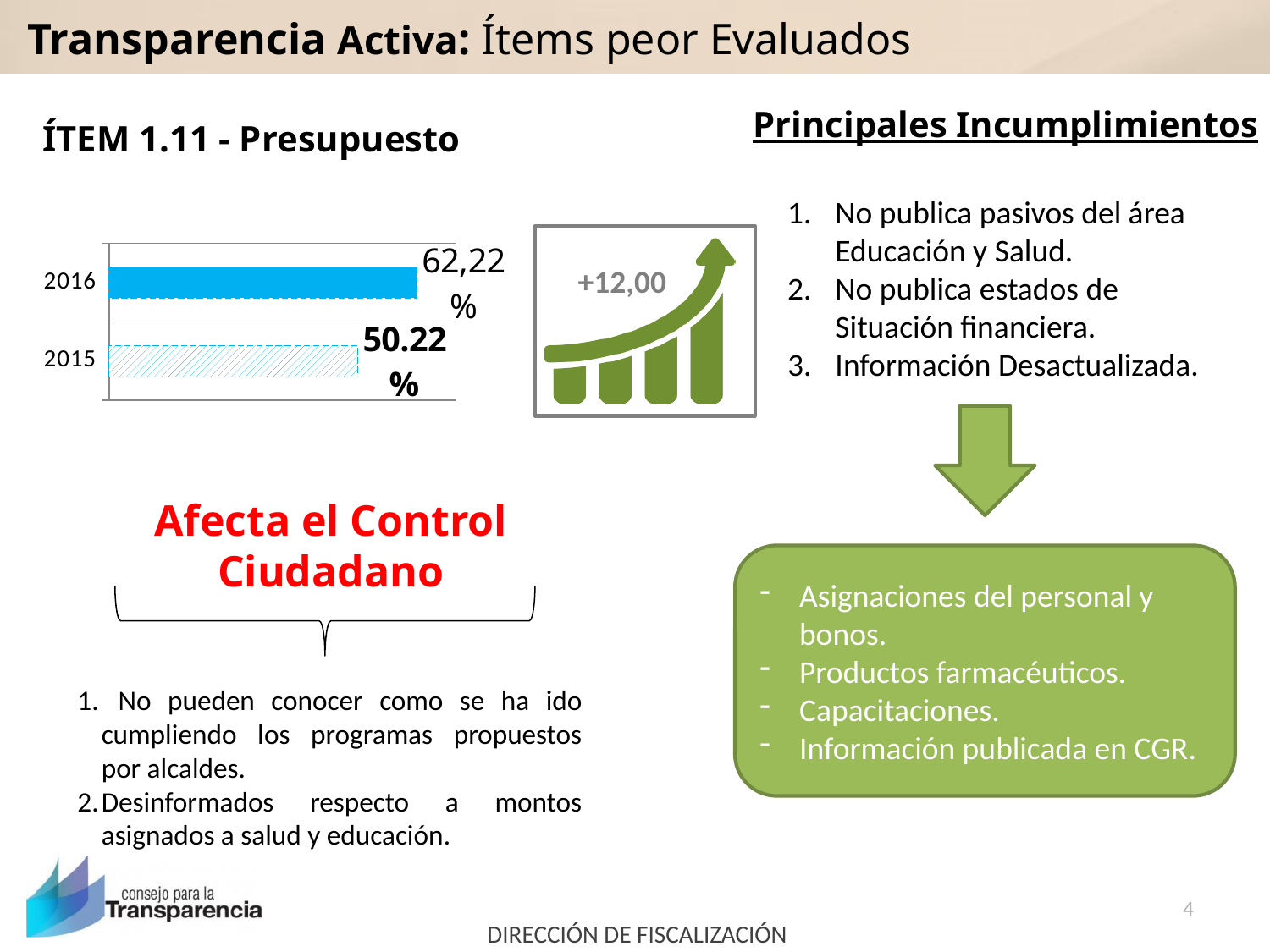
What change is printed in the green icon next to the bar chart? +12,00 What kind of chart is shown on the slide? bar chart Which item does the bar chart refer to? ÍTEM 1.11 - Presupuesto Which year has the higher value in the bar chart? 2016 What is the value for 2016 in the bar chart? 62,22% Which year has the lower value in the bar chart? 2015 Did the value rise or fall from 2015 to 2016? rise How many years are shown in the bar chart? 2 Is the value for 2016 larger or smaller than the value for 2015? larger What is the value for 2015 in the bar chart? 50.22% By how much did the value increase from 2015 to 2016 in the bar chart? 12,00